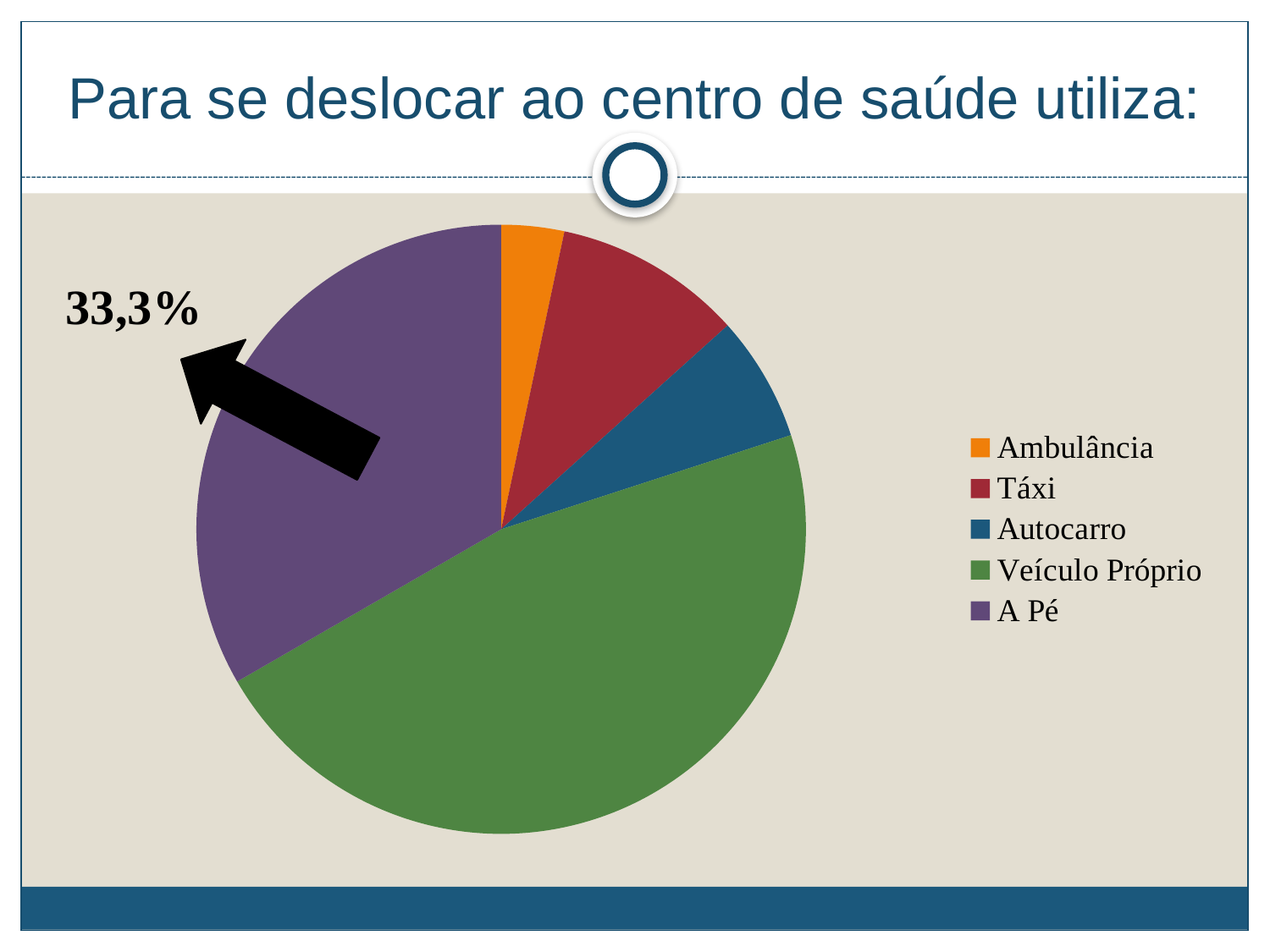
Which category has the largest slice of the pie? Veículo Próprio Which slice is larger, Táxi or Autocarro? Táxi Which category has the smallest slice of the pie? Ambulância What share of the pie does the 'A Pé' slice represent, as labelled on the slide? 33,3% How many categories does the pie chart have? 5 What kind of chart is shown on the slide? pie chart Which slice is larger, Ambulância or Autocarro? Autocarro What is the title of the slide containing the pie chart? Para se deslocar ao centro de saúde utiliza: How many entries does the legend list? 5 Which slice is larger, Veículo Próprio or A Pé? Veículo Próprio Which category is shown in green in the pie chart? Veículo Próprio